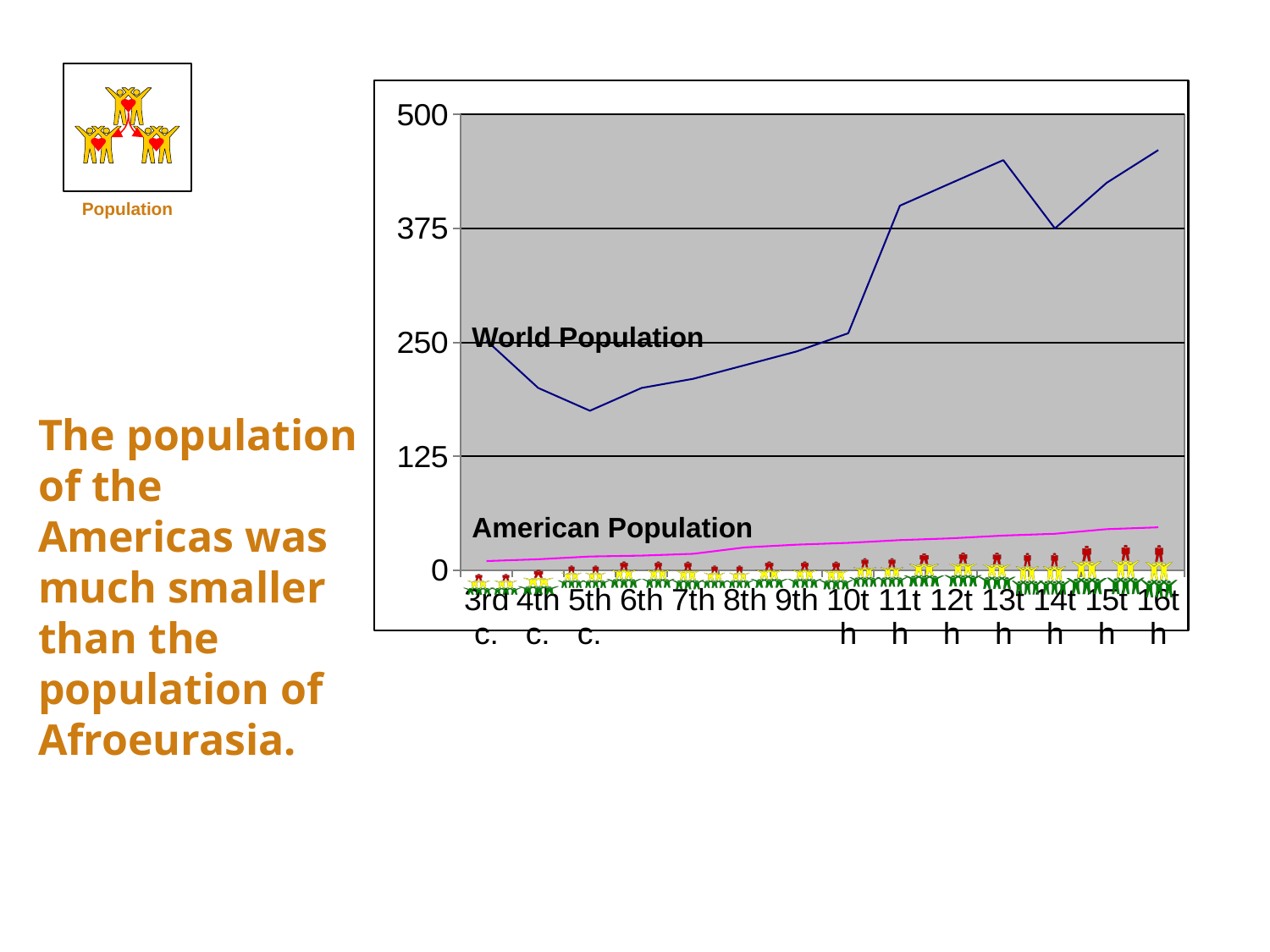
Is the World Population value for the 11th century greater or less than 375? greater In which century does the World Population line reach its lowest value? 5th c. In which century does the World Population line reach its highest value? 16th Which is larger, the World Population value for the 13th century or for the 14th century? 13th century Is the American Population value for the 16th century greater or less than 125? less What kind of chart is shown on the slide? line chart What colour is the World Population line on the chart? blue Which series has the larger value in the 16th century, World Population or American Population? World Population Does the American Population line generally rise or fall from the 3rd century to the 16th century? rise How many data series are plotted on the chart? 2 How many centuries are plotted along the x axis of the chart? 14 Is the World Population value for the 5th century greater or less than 250? less